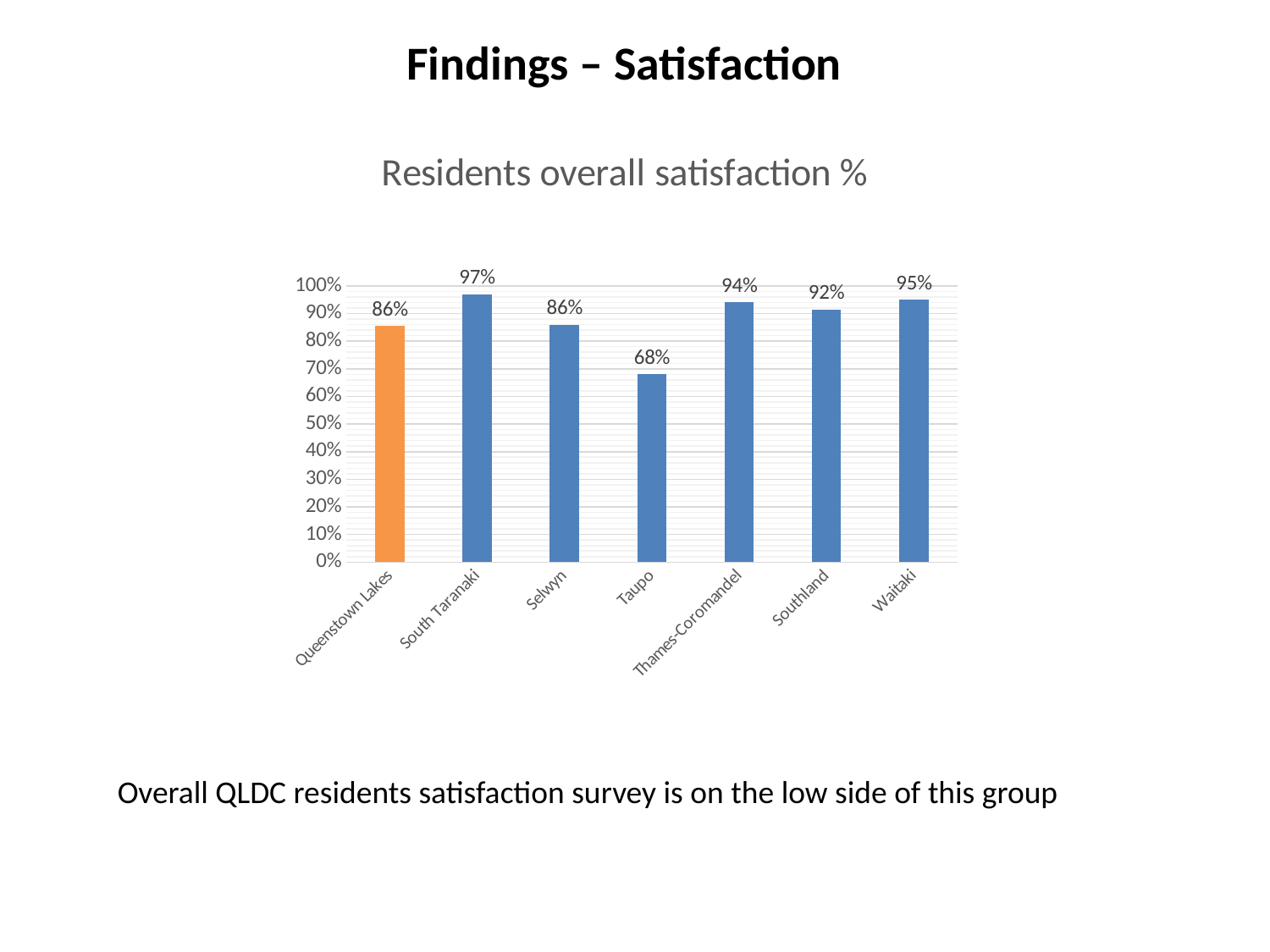
Which has a higher satisfaction percentage, Thames-Coromandel or Southland? Thames-Coromandel What kind of chart is shown on the slide? Bar chart How many districts are shown in the chart? 7 What is the difference in satisfaction percentage between Waitaki and Queenstown Lakes? 9% What is the title of the chart? Residents overall satisfaction % Is the satisfaction value for Taupo greater or less than 70%? less Which district has the highest residents overall satisfaction percentage? South Taranaki Which district's bar is coloured orange rather than blue? Queenstown Lakes What is the residents overall satisfaction percentage for Southland? 92% What is the residents overall satisfaction percentage for South Taranaki? 97% What is the residents overall satisfaction percentage for Taupo? 68% Which district has the lowest residents overall satisfaction percentage? Taupo